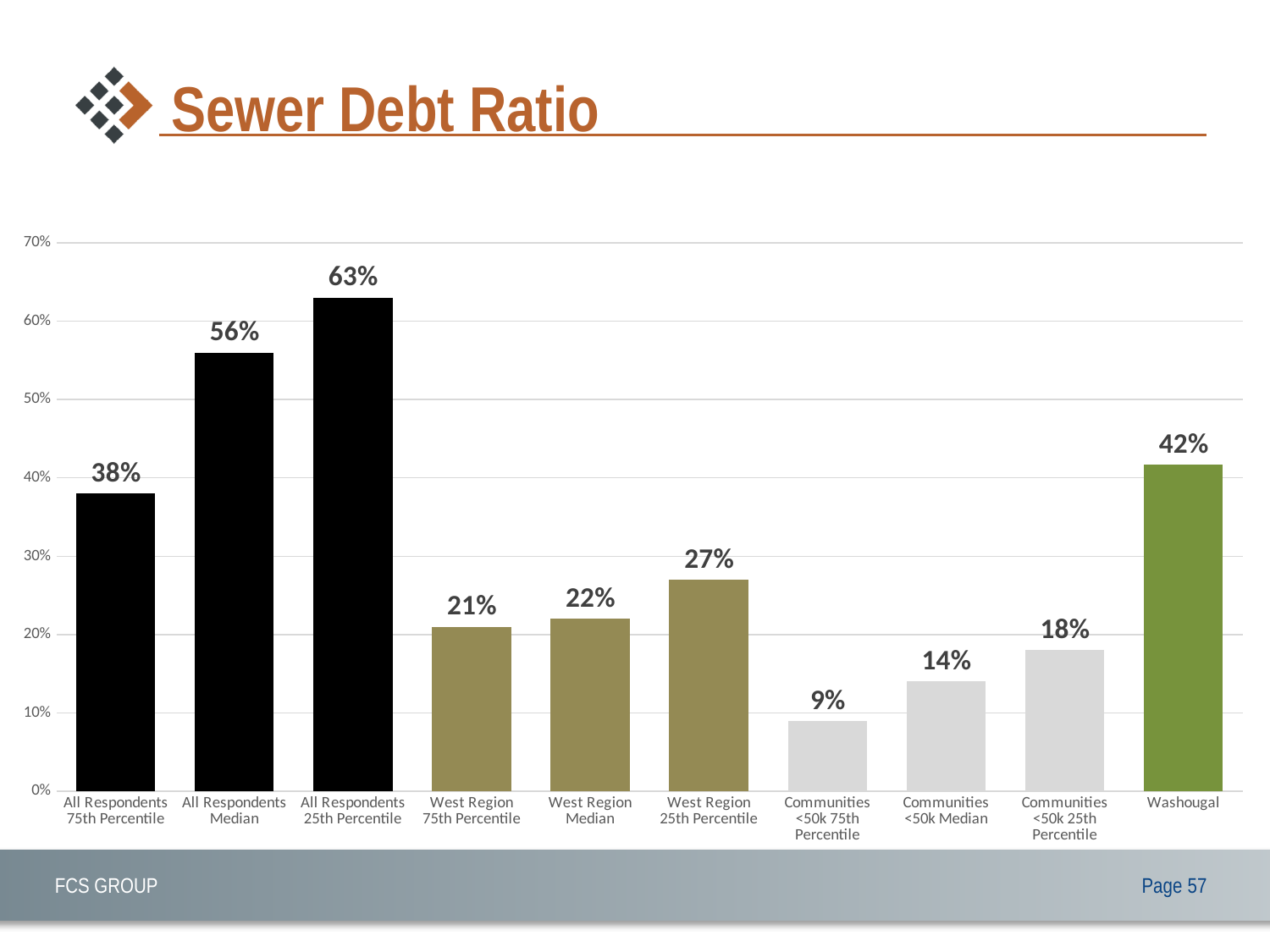
Which category has the lowest value? Communities <50k 75th Percentile How many categories are shown on the x axis? 10 What is the difference between Washougal and West Region Median? 20% What is the difference between All Respondents 25th Percentile and All Respondents 75th Percentile? 25% What is the title of the slide? Sewer Debt Ratio Which category has the highest value? All Respondents 25th Percentile What is the value for All Respondents Median? 56% What is the value for Communities <50k 75th Percentile? 9% Which is larger, West Region 25th Percentile or Communities <50k 25th Percentile? West Region 25th Percentile What is the value for Washougal? 42% What kind of chart is shown on the slide? bar chart Is the value for Washougal greater or less than 40%? greater